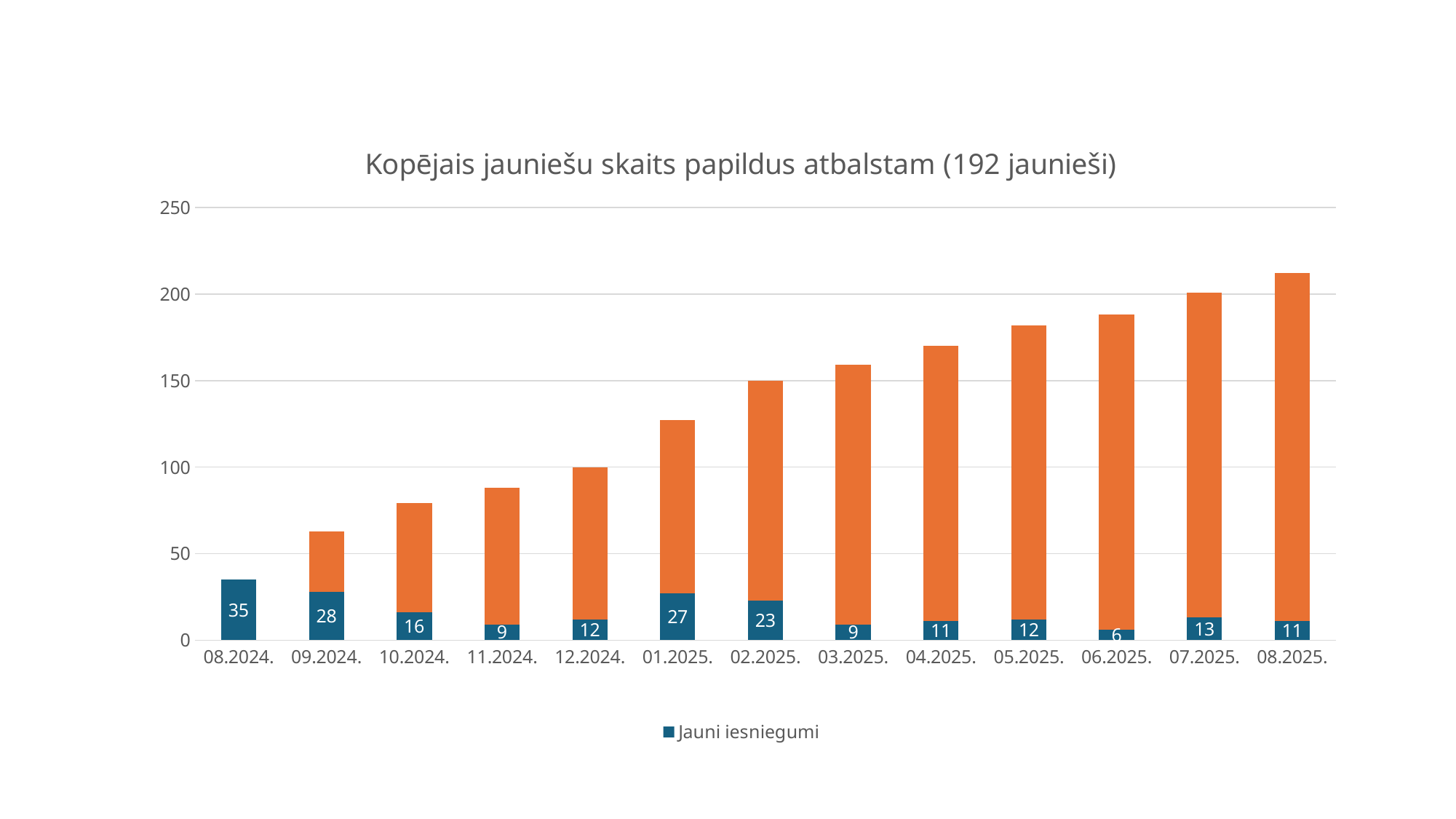
What is the value of Jauni iesniegumi for 01.2025.? 27 Which month has the lowest value for Jauni iesniegumi? 06.2025. What is the difference between the Jauni iesniegumi values for 09.2024. and 10.2024.? 12 Which has a larger Jauni iesniegumi value, 02.2025. or 07.2025.? 02.2025. What type of chart is shown on the slide? Stacked bar chart How many months are shown on the x axis? 13 What is the value of Jauni iesniegumi for 06.2025.? 6 Is the total height of the bar for 08.2025. greater or less than 200? greater Is the total height of the bar for 09.2024. greater or less than 100? less Which month has the highest value for Jauni iesniegumi? 08.2024. What is the value of Jauni iesniegumi for 08.2024.? 35 How many series does the legend list? 1